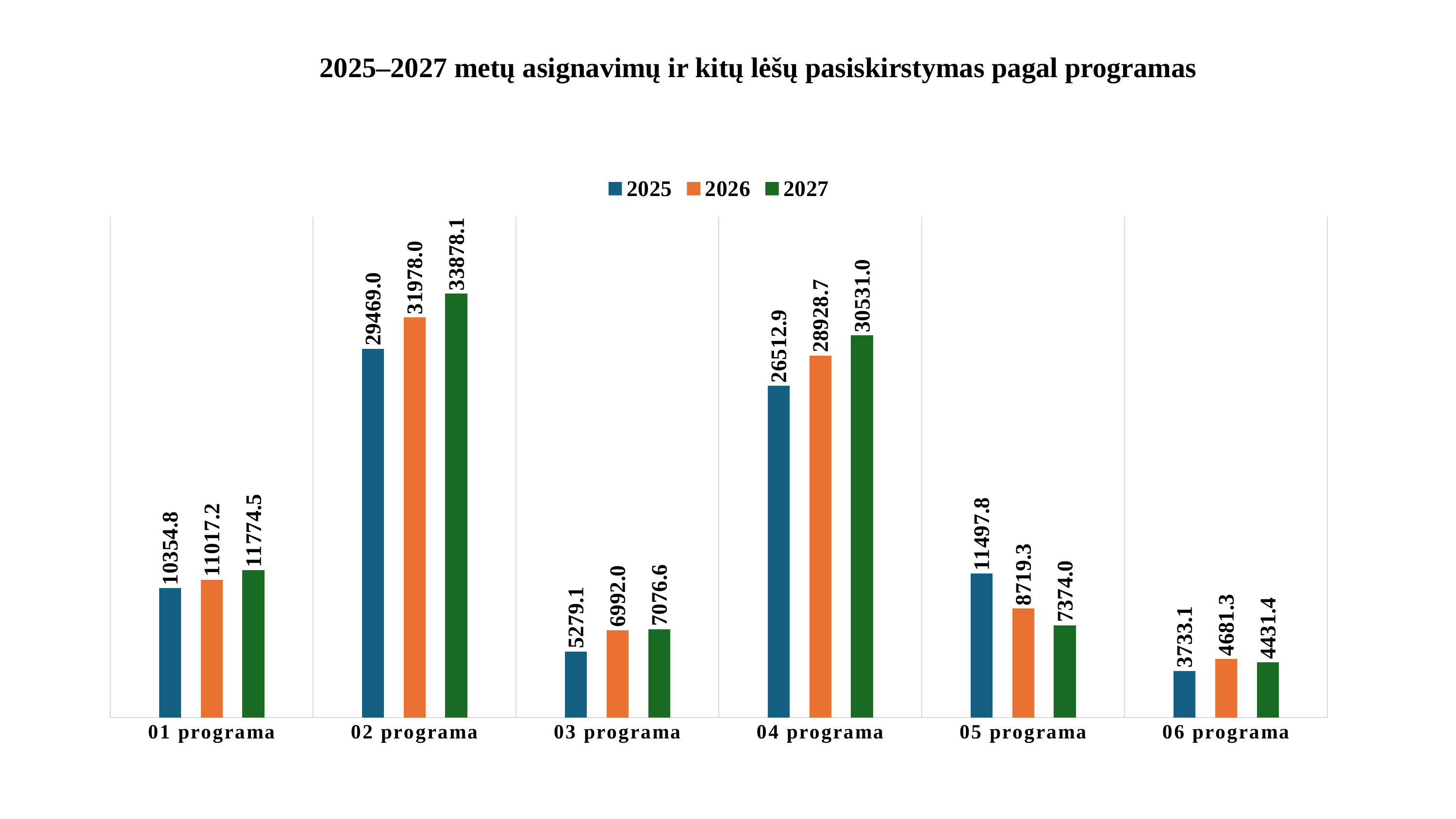
Which programa has the highest value in the 2027 series? 02 programa Which is larger for 04 programa: the 2025 value or the 2027 value? 2027 What is the value for 02 programa in the 2027 series? 33878.1 What is the difference between the 2027 and 2025 values for 02 programa? 4409.1 What is the difference between the 2025 and 2027 values for 05 programa? 4123.8 What is the value for 05 programa in the 2025 series? 11497.8 How many programa categories are shown on the x axis? 6 Which programa has the lowest value in the 2025 series? 06 programa How many series does the legend list? 3 What is the value for 03 programa in the 2026 series? 6992.0 What kind of chart is shown on the slide? bar chart Do the values for 05 programa rise or fall from 2025 to 2027? fall